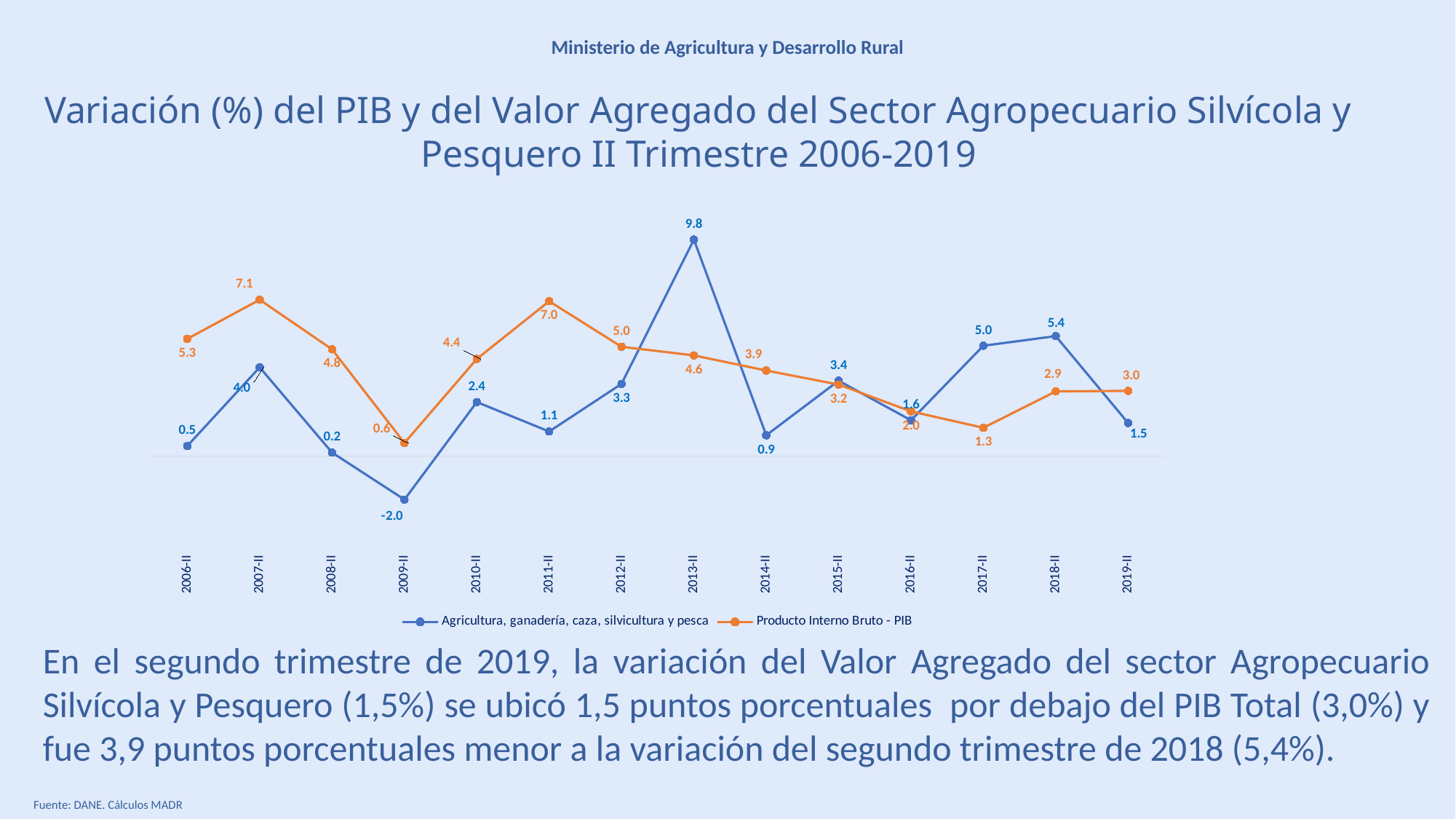
How many periods are plotted along the x axis? 14 What colour is the line for Producto Interno Bruto - PIB? orange What is the value for Producto Interno Bruto - PIB in 2007-II? 7.1 What is the difference between the PIB value and the Agricultura value in 2019-II? 1.5 Which series has the larger value in 2017-II, Agricultura or PIB? Agricultura, ganadería, caza, silvicultura y pesca What is the value for Agricultura, ganadería, caza, silvicultura y pesca in 2009-II? -2.0 What is the value for Agricultura, ganadería, caza, silvicultura y pesca in 2013-II? 9.8 Does the Agricultura, ganadería, caza, silvicultura y pesca series rise or fall from 2018-II to 2019-II? fall How many series does the legend list? 2 In which period does the Agricultura, ganadería, caza, silvicultura y pesca series reach its highest value? 2013-II What type of chart is shown on the slide? line chart In which period does the Producto Interno Bruto - PIB series reach its lowest value? 2009-II